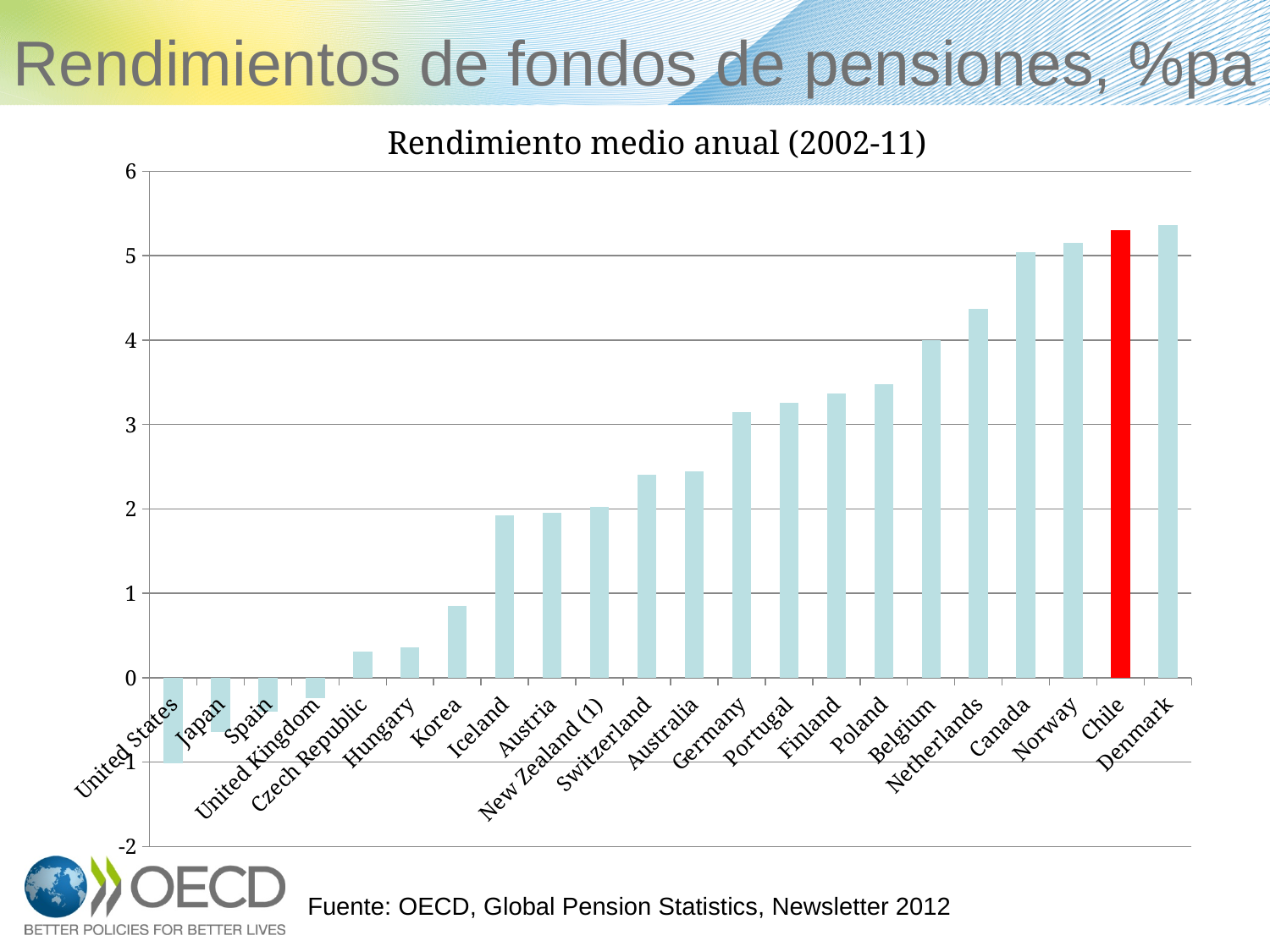
What is the title of the chart? Rendimiento medio anual (2002-11) Do the values rise or fall moving from left to right along the x axis? rise Which country's bar is highlighted in red? Chile Which country has the lowest value on the chart? United States Is the value for Switzerland greater or less than 2? greater Is the value for Japan greater or less than 0? less Which has the larger value, Korea or Hungary? Korea Which has the larger value, Netherlands or Belgium? Netherlands Is the value for Korea greater or less than 1? less How many countries are shown on the chart? 22 What kind of chart is shown on the slide? bar chart